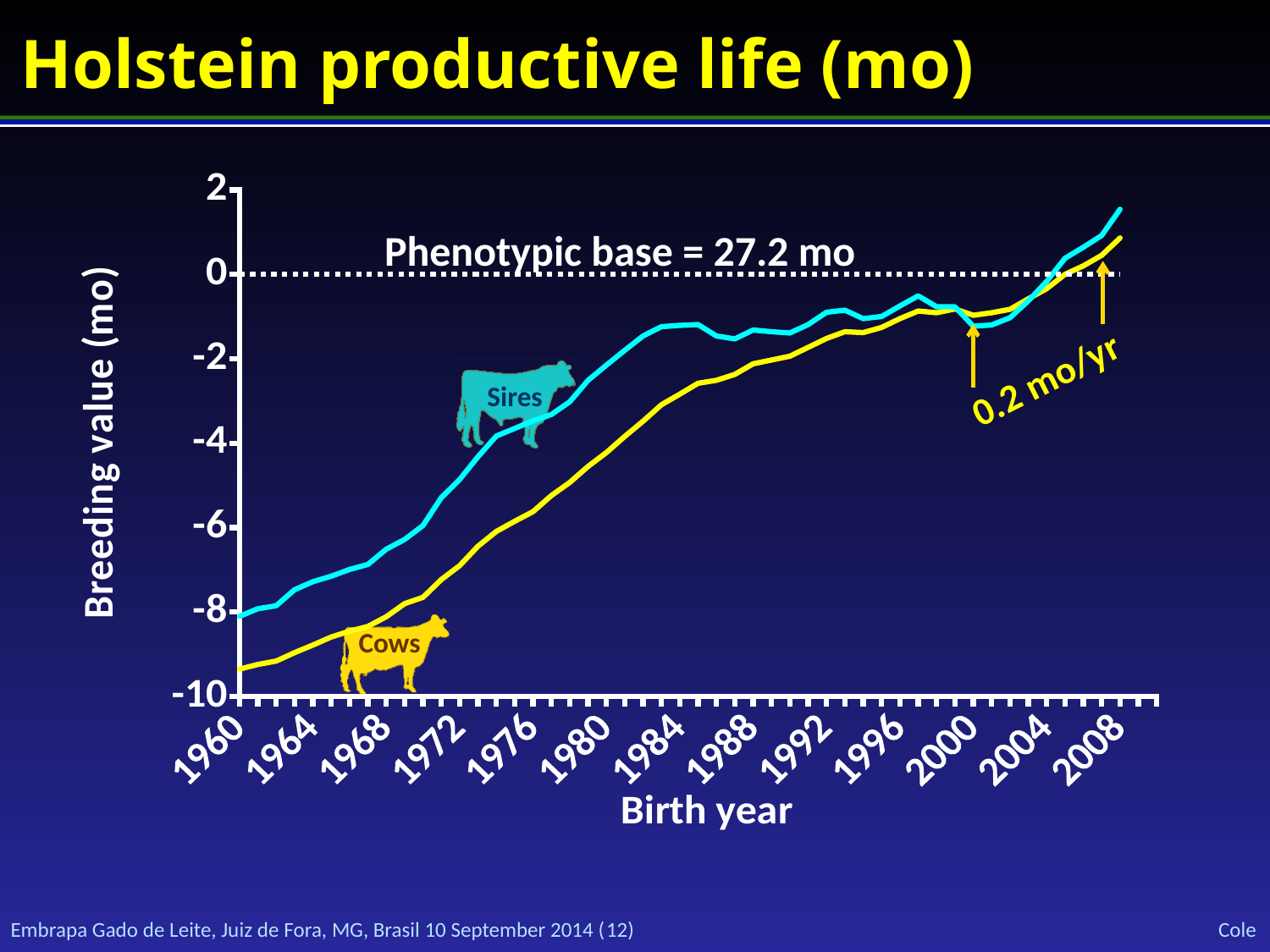
Is the breeding value for Sires in 2008 greater or less than 0? greater In 1960, which series has the higher breeding value, Sires or Cows? Sires Is the breeding value for Sires in 1984 greater or less than -2? greater Do the breeding values for Sires rise or fall from 1960 to 2008? rise How many series are plotted in the chart? 3 What kind of chart is shown on the slide? line chart What is the phenotypic base stated on the chart? 27.2 mo What rate of change is annotated near the right end of the chart? 0.2 mo/yr Is the breeding value for Cows in 1984 greater or less than -2? less Do the breeding values for Cows rise or fall from 1960 to 2008? rise